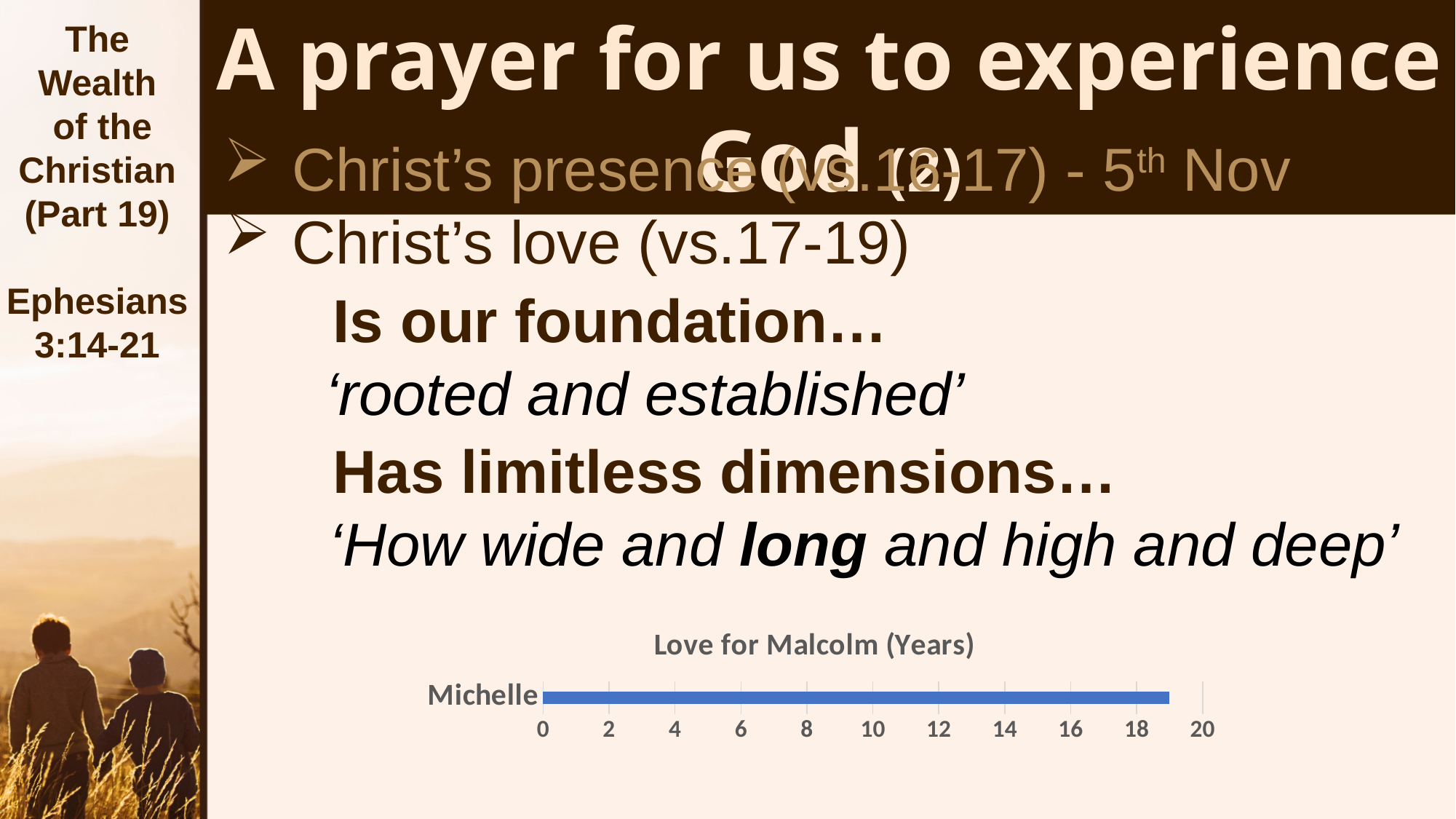
What is the name of the only category on the chart's vertical axis? Michelle Is the value for Michelle greater or less than 20? less What kind of chart is shown on the slide? bar chart Is the value for Michelle greater or less than 18? greater Is the value for Michelle greater or less than 16? greater How many categories does the chart show? 1 What is the title of the chart? Love for Malcolm (Years)